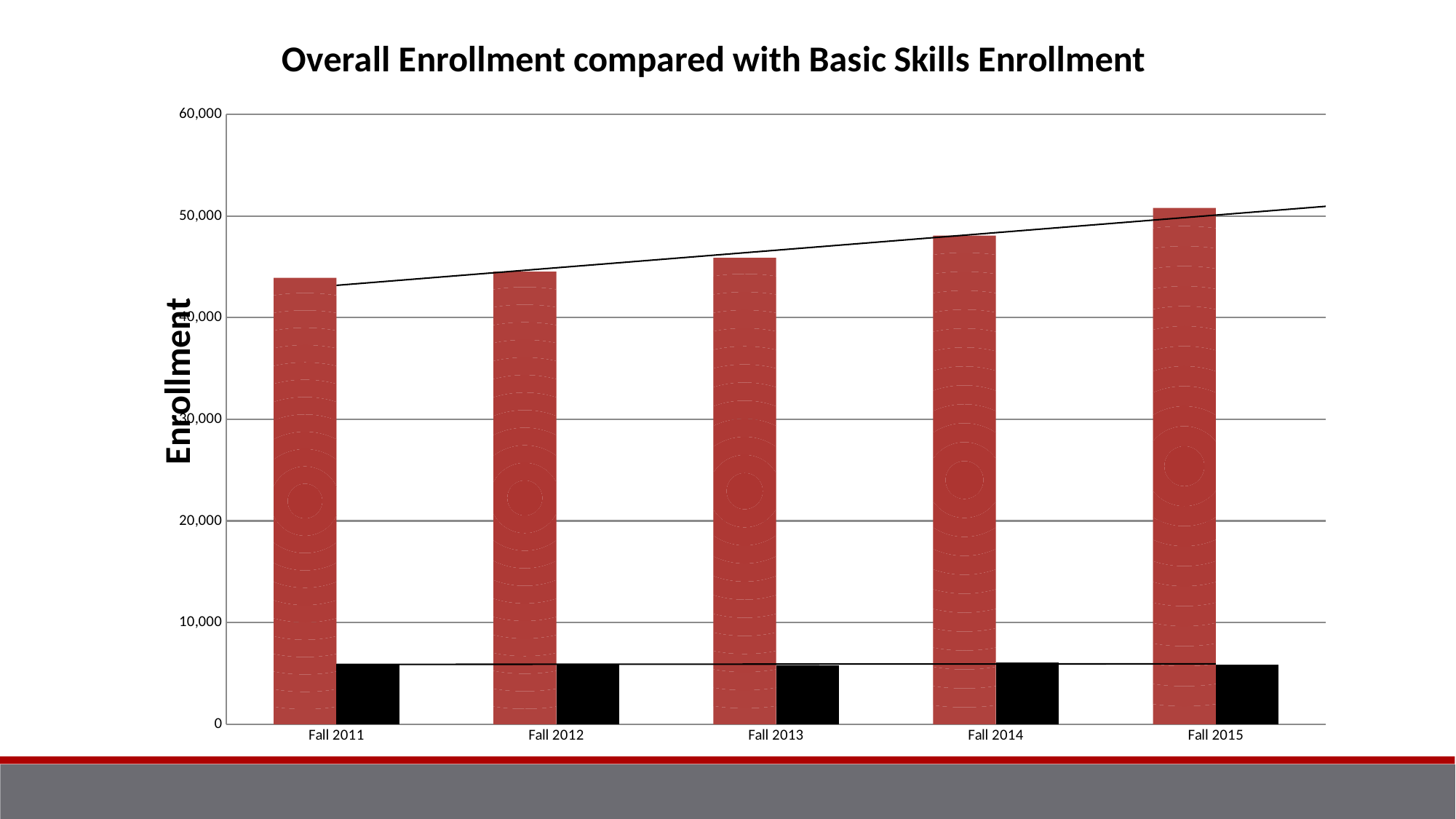
Which is larger, the red bar for Fall 2013 or the red bar for Fall 2015? Fall 2015 Do the red bars rise or fall from Fall 2011 to Fall 2015? rise What is the title of the chart? Overall Enrollment compared with Basic Skills Enrollment What is the label on the vertical axis? Enrollment How many categories (terms) are shown on the x axis? 5 Is the red bar for Fall 2015 greater or less than 50,000? greater What kind of chart is shown on the slide? bar chart Which term has the tallest red bar? Fall 2015 Is the red bar for Fall 2011 greater or less than 50,000? less Is the red bar for Fall 2014 greater or less than 40,000? greater